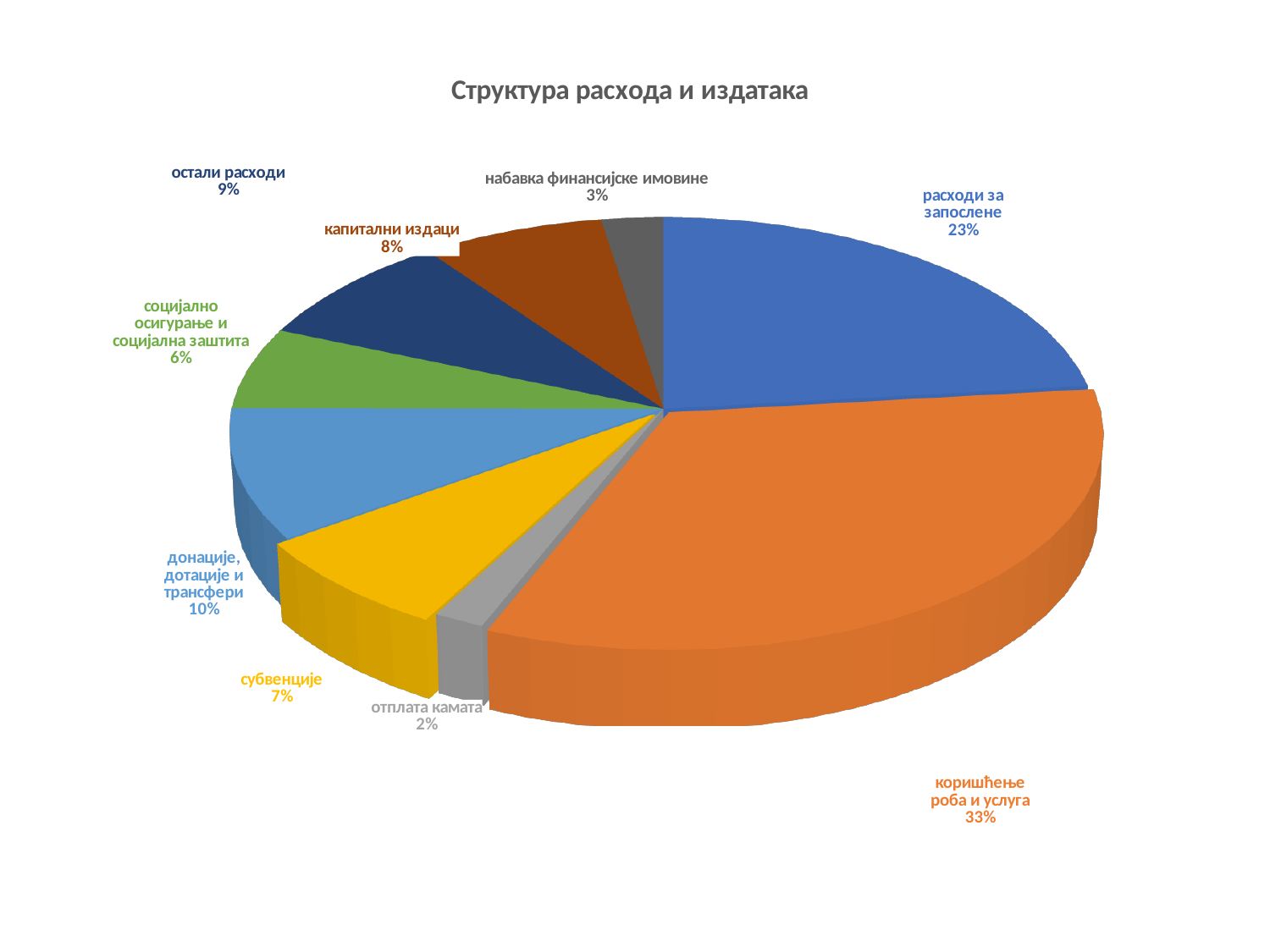
What is the value for 'донације, дотације и трансфери'? 10% Which category has the smallest share of the pie? отплата камата What is the value for 'отплата камата'? 2% What is the value for 'набавка финансијске имовине'? 3% What share of the pie is 'коришћење роба и услуга'? 33% What is the difference between the shares of 'коришћење роба и услуга' and 'расходи за запослене'? 10% What is the title of the chart? Структура расхода и издатака Which category has the largest share of the pie? коришћење роба и услуга What share of the pie is 'расходи за запослене'? 23% Which is larger, 'остали расходи' or 'капитални издаци'? остали расходи How many slices does the pie chart have? 9 What kind of chart is shown on the slide? pie chart